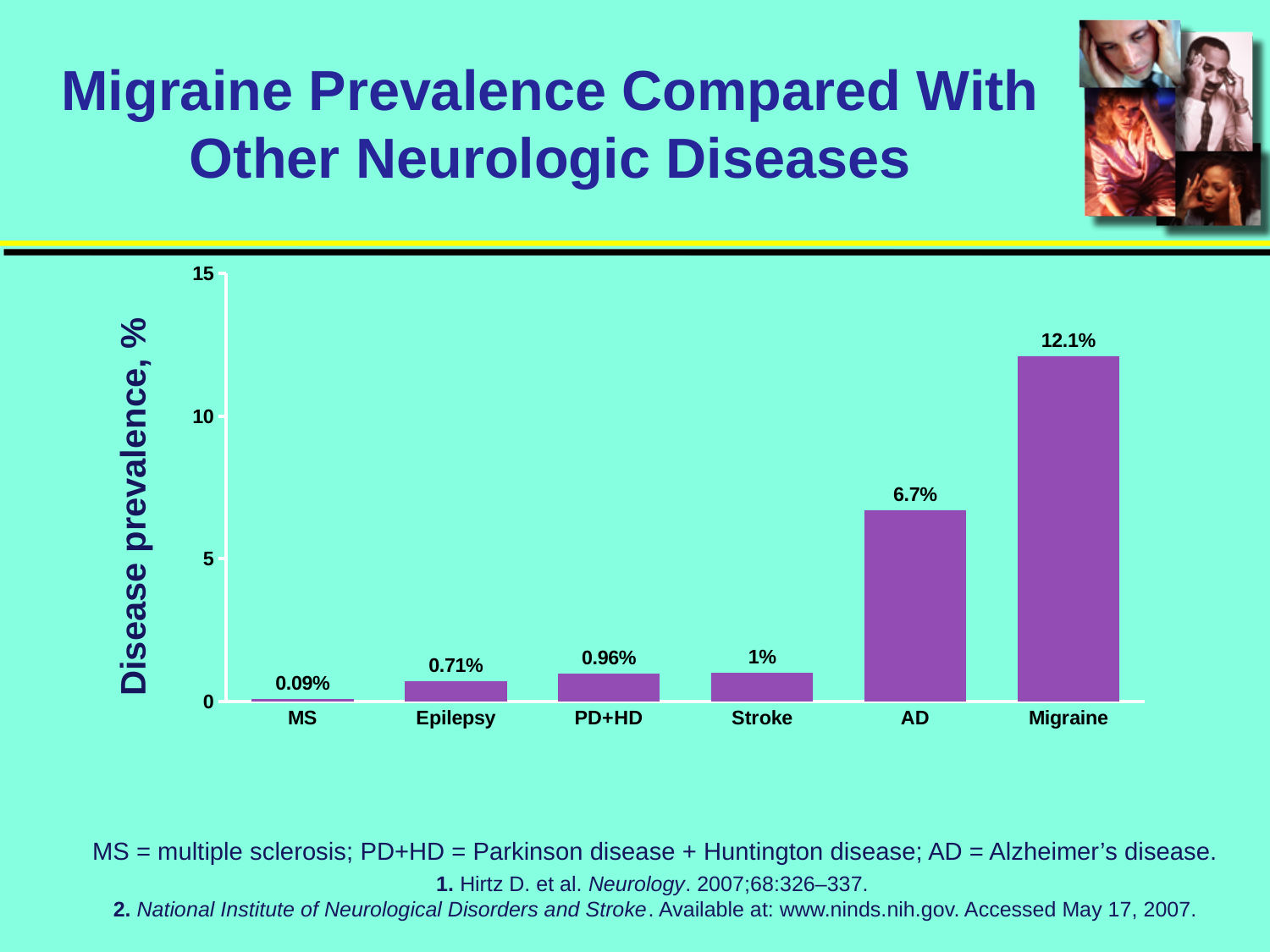
What is the disease prevalence for AD? 6.7% Which has a higher prevalence, Epilepsy or PD+HD? PD+HD How many diseases are shown on the chart? 6 What is the label of the y axis? Disease prevalence, % What kind of chart is shown on the slide? Bar chart What is the disease prevalence for Stroke? 1% Which disease has the highest prevalence? Migraine What is the disease prevalence for Migraine? 12.1% What is the disease prevalence for MS? 0.09% Is the value for AD greater or less than 5? greater Which disease has the lowest prevalence? MS What is the difference in prevalence between Migraine and AD? 5.4%